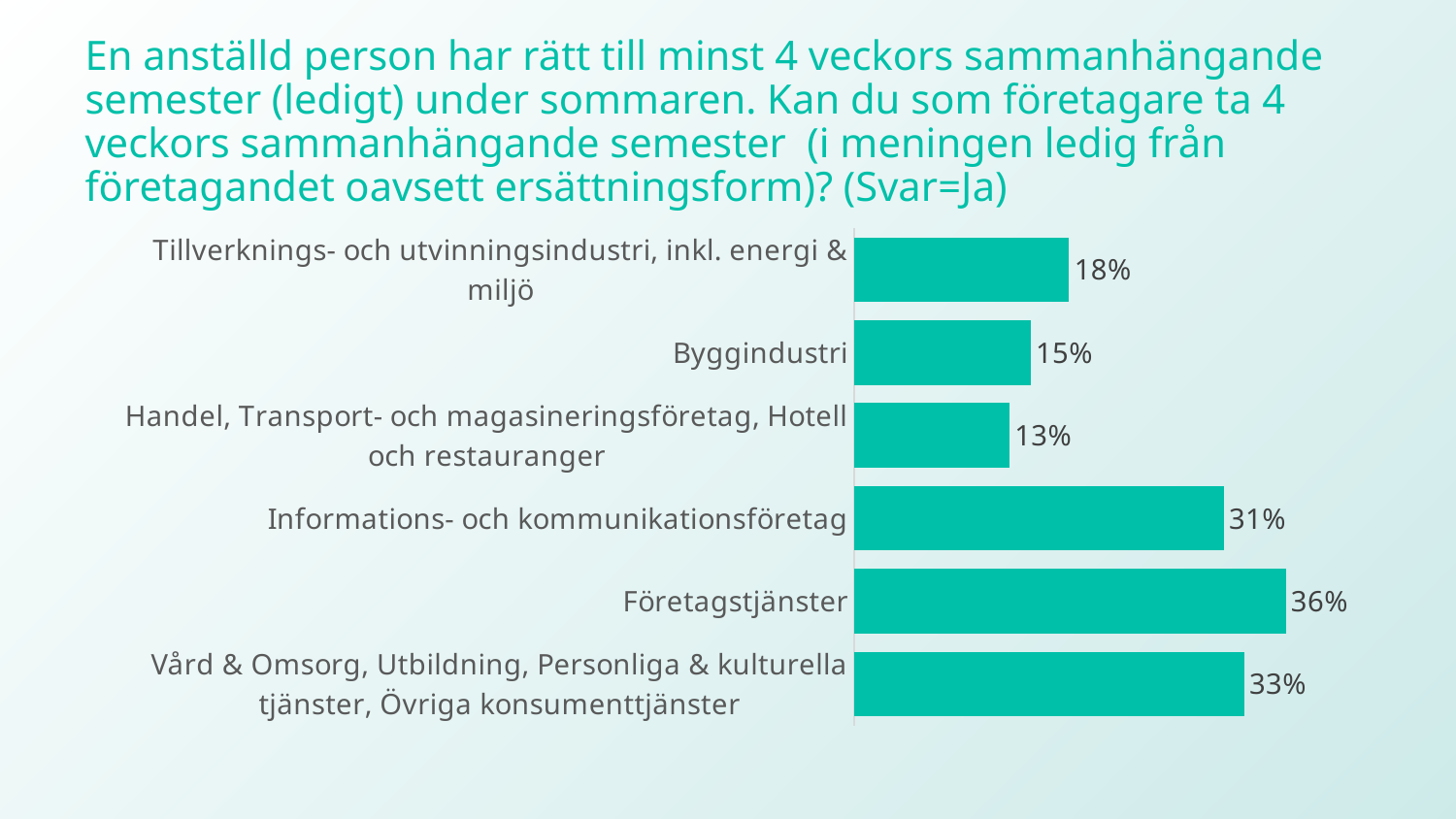
What colour are the bars in the chart? Teal What is the value for Byggindustri? 15% What is the value for Företagstjänster? 36% What kind of chart is shown on the slide? Bar chart Which is larger, the value for Tillverknings- och utvinningsindustri, inkl. energi & miljö or the value for Byggindustri? Tillverknings- och utvinningsindustri, inkl. energi & miljö Which category has the lowest value? Handel, Transport- och magasineringsföretag, Hotell och restauranger What is the difference between the values for Företagstjänster and Byggindustri? 21% Which category has the highest value? Företagstjänster What is the difference between the values for Vård & Omsorg, Utbildning, Personliga & kulturella tjänster, Övriga konsumenttjänster and Informations- och kommunikationsföretag? 2% What is the value for Handel, Transport- och magasineringsföretag, Hotell och restauranger? 13% How many categories are shown in the chart? 6 What is the value for Informations- och kommunikationsföretag? 31%